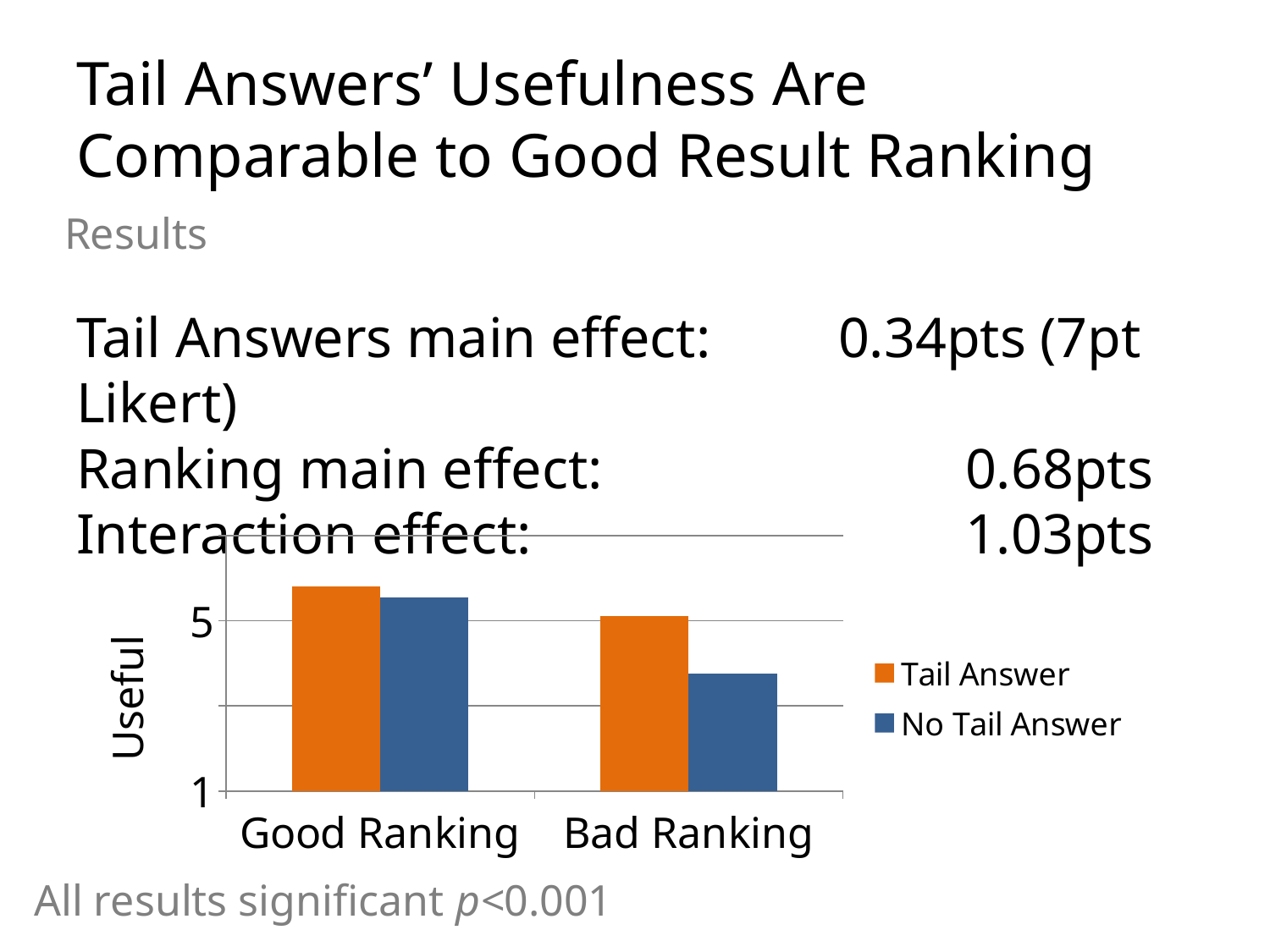
Does the Tail Answer series rise or fall from Good Ranking to Bad Ranking? fall What kind of chart is shown on the slide? bar chart What is the label on the chart's y axis? Useful Which bar in the chart is the lowest? No Tail Answer under Bad Ranking Which colour represents the Tail Answer series in the chart? orange Is the value for No Tail Answer under Bad Ranking greater or less than 5? less Under Bad Ranking, which is larger: Tail Answer or No Tail Answer? Tail Answer How many categories are shown on the x axis of the chart? 2 How many series does the chart's legend list? 2 Is the value for Tail Answer under Good Ranking greater or less than 5? greater Does the No Tail Answer series rise or fall from Good Ranking to Bad Ranking? fall Is the value for No Tail Answer under Good Ranking greater or less than 5? greater